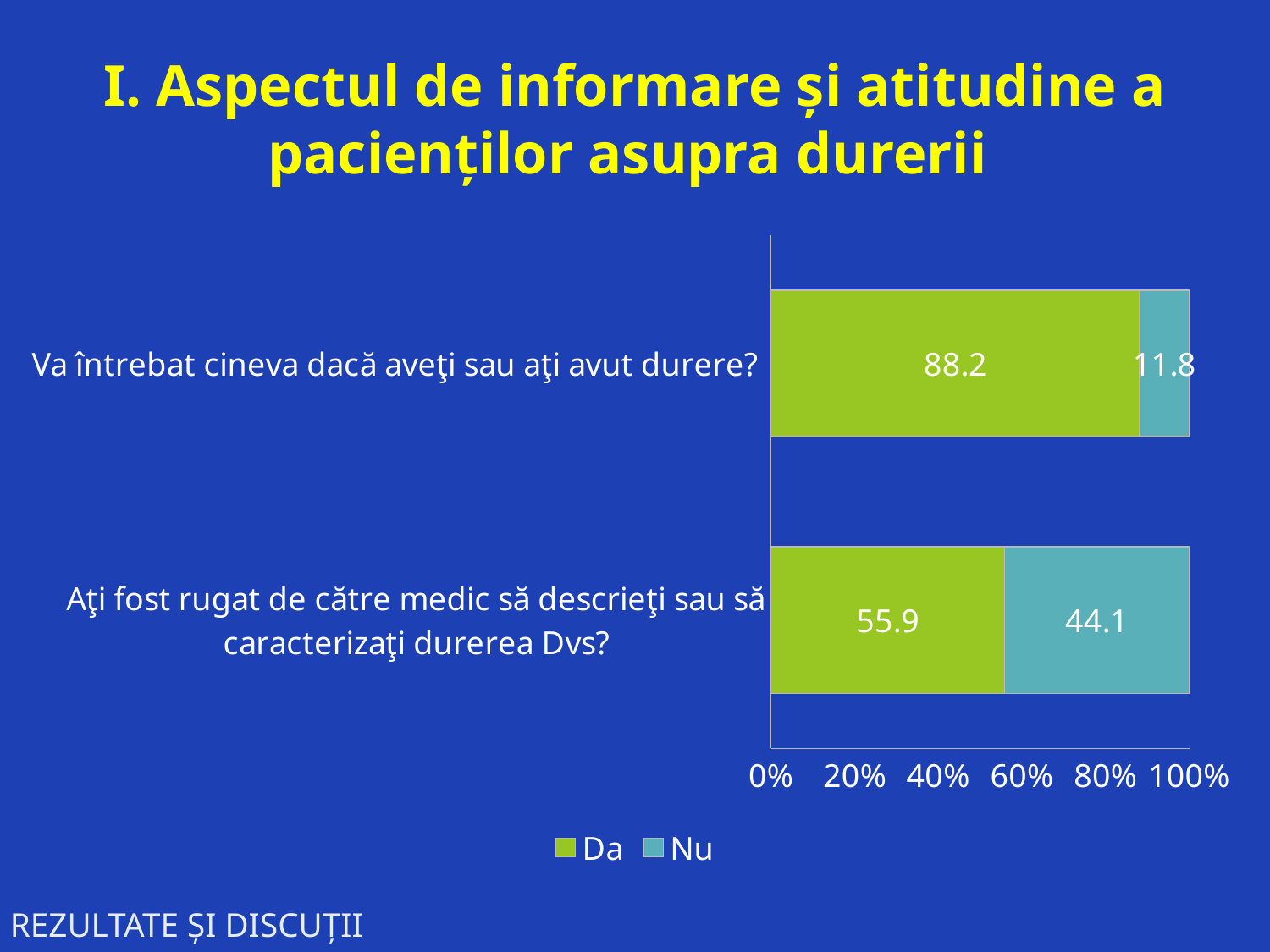
What is the total of the stacked bar for "Va întrebat cineva dacă aveţi sau aţi avut durere?"? 100 For "Aţi fost rugat de către medic să descrieţi sau să caracterizaţi durerea Dvs?", which is larger, "Da" or "Nu"? Da Which question has the lower "Nu" value? Va întrebat cineva dacă aveţi sau aţi avut durere? What is the "Nu" value for "Aţi fost rugat de către medic să descrieţi sau să caracterizaţi durerea Dvs?"? 44.1 What is the "Da" value for "Aţi fost rugat de către medic să descrieţi sau să caracterizaţi durerea Dvs?"? 55.9 Which question has the higher "Da" value? Va întrebat cineva dacă aveţi sau aţi avut durere? What is the "Nu" value for "Va întrebat cineva dacă aveţi sau aţi avut durere?"? 11.8 What is the difference between the "Da" values of the two questions? 32.3 What is the "Da" value for "Va întrebat cineva dacă aveţi sau aţi avut durere?"? 88.2 How many series does the legend list? 2 What kind of chart is shown on the slide? Stacked bar chart How many categories (questions) are shown on the chart? 2